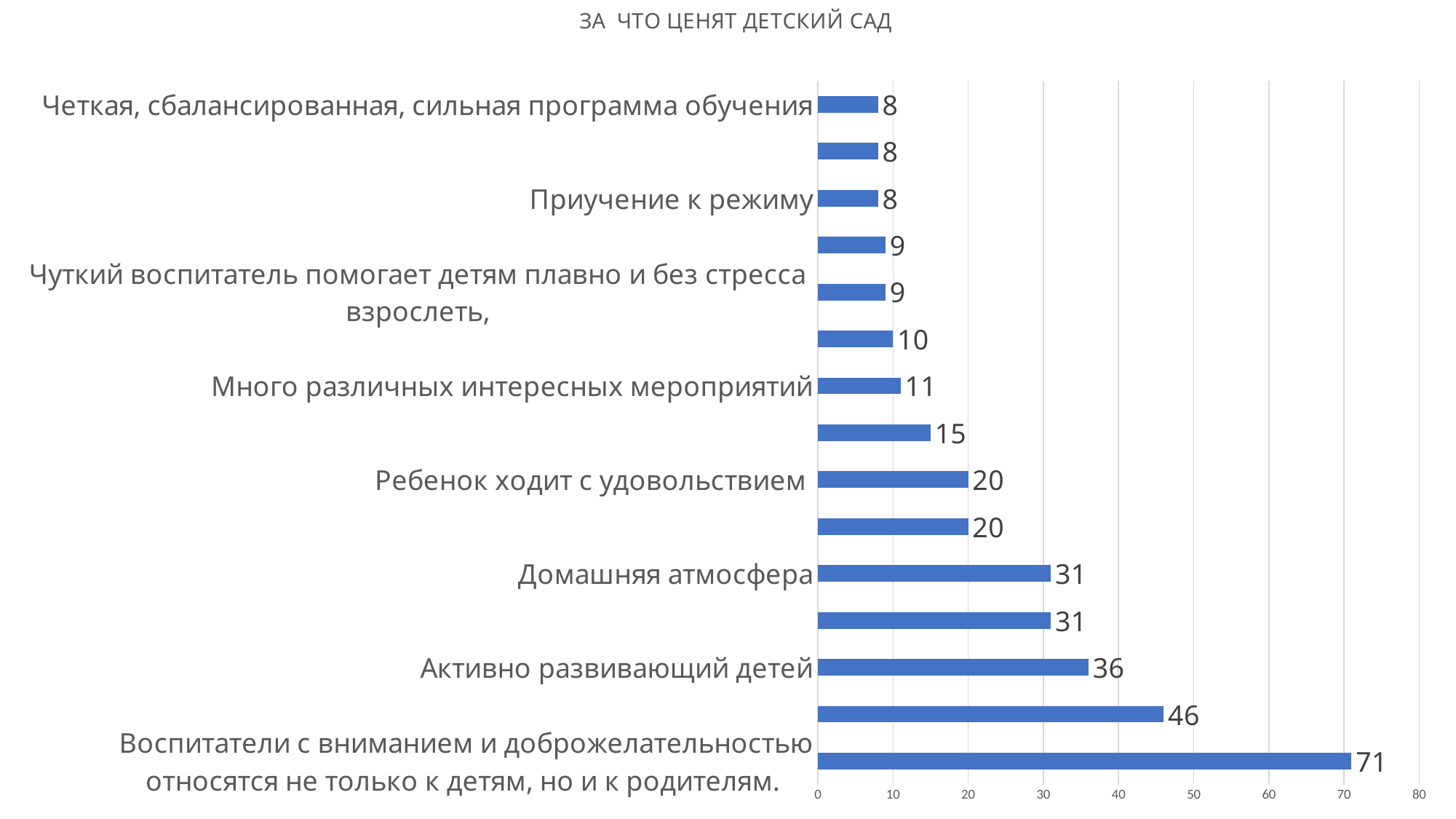
Which is larger, the value for "Ребенок ходит с удовольствием" or the value for "Много различных интересных мероприятий"? Ребенок ходит с удовольствием What is the value for "Домашняя атмосфера"? 31 What is the value for "Приучение к режиму"? 8 What is the difference between the values for "Активно развивающий детей" and "Домашняя атмосфера"? 5 What is the value for "Много различных интересных мероприятий"? 11 Which category has the highest value? Воспитатели с вниманием и доброжелательностью относятся не только к детям, но и к родителям. What is the largest value shown on the chart? 71 What is the value for "Ребенок ходит с удовольствием"? 20 What type of chart is shown on the slide? bar chart What is the value for "Активно развивающий детей"? 36 What is the title of the chart? ЗА ЧТО ЦЕНЯТ ДЕТСКИЙ САД How many bars are plotted on the chart? 15